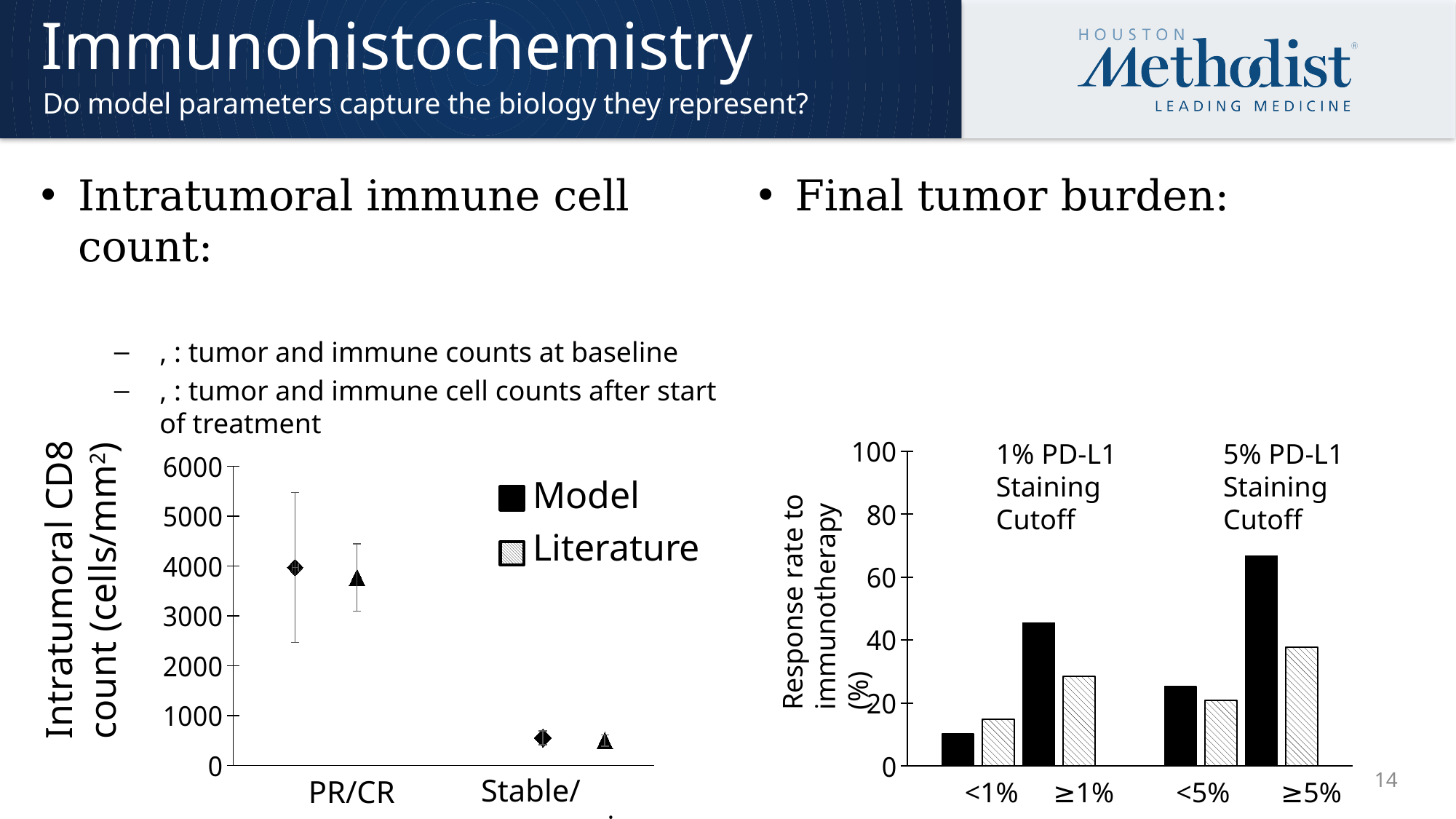
On the left chart (Intratumoral CD8 count), is the Model value for PR/CR greater or less than 3000? greater On the right chart (Response rate to immunotherapy), how many categories are shown on the x axis? 4 On the left chart (Intratumoral CD8 count), what is the label of the y axis? Intratumoral CD8 count (cells/mm²) On the right chart (Response rate to immunotherapy), which is larger for ≥1%: the Model bar or the Literature bar? Model On the left chart (Intratumoral CD8 count), is the Literature value for Stable/ greater or less than 1000? less On the right chart (Response rate to immunotherapy), is the Literature value for <1% greater or less than 20? less On the right chart (Response rate to immunotherapy), how many series does the legend on the slide list? 2 On the right chart (Response rate to immunotherapy), which category has the highest Model bar? ≥5% On the right chart (Response rate to immunotherapy), which category has the lowest Model bar? <1% On the right chart (Response rate to immunotherapy), what kind of chart is it? bar chart On the right chart (Response rate to immunotherapy), which is larger for <1%: the Model bar or the Literature bar? Literature